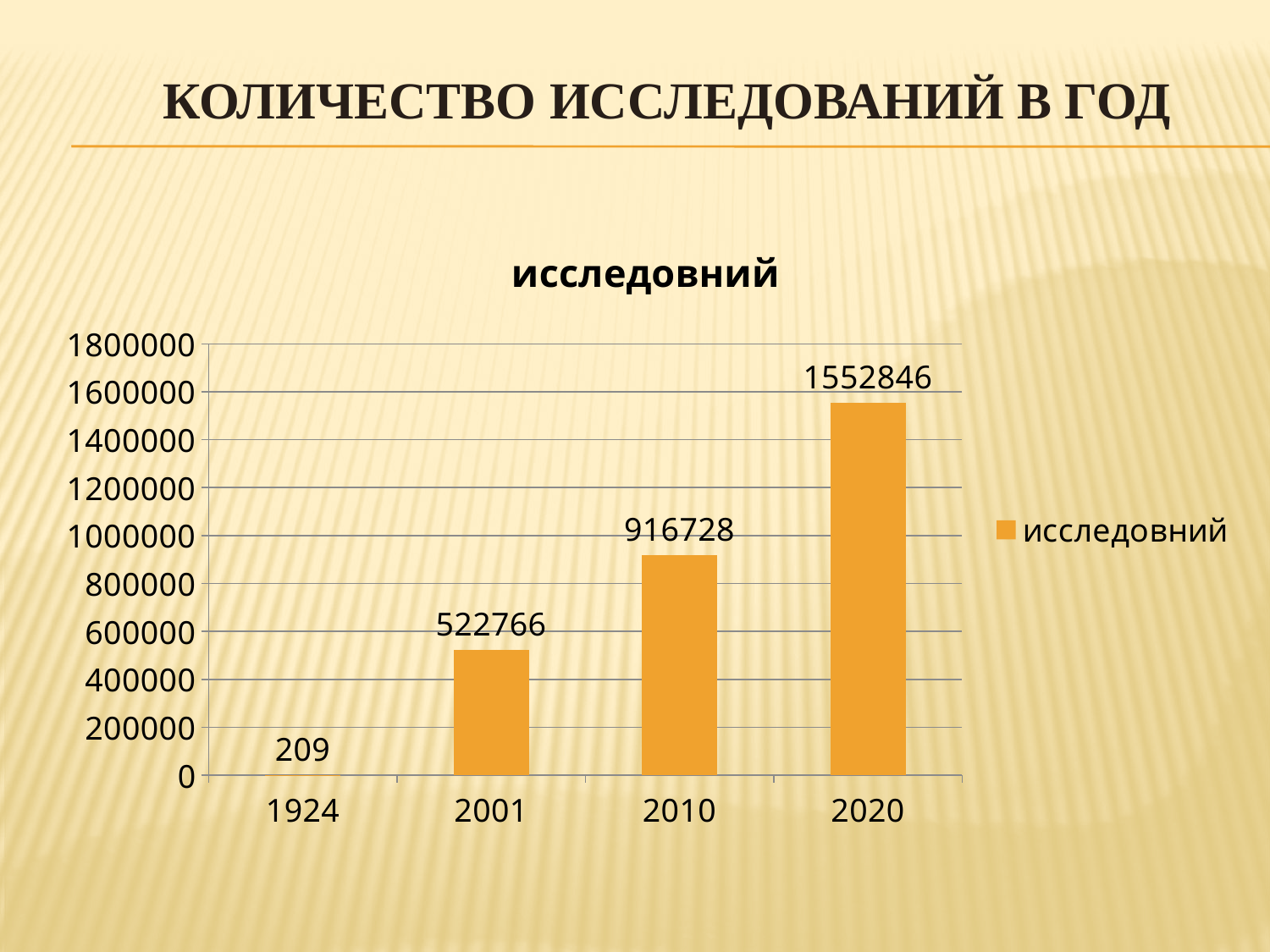
Which year has the highest value? 2020 What is the value for 2001? 522766 Do the values rise or fall from 1924 to 2020? rise How many years are shown on the x axis? 4 What is the difference between the values for 2020 and 2010? 636118 What kind of chart is this? bar chart Which year has the lowest value? 1924 Which is larger, the value for 2001 or the value for 2010? 2010 What is the value for 2020? 1552846 What is the value for 1924? 209 What is the value for 2010? 916728 What is the difference between the values for 2010 and 2001? 393962